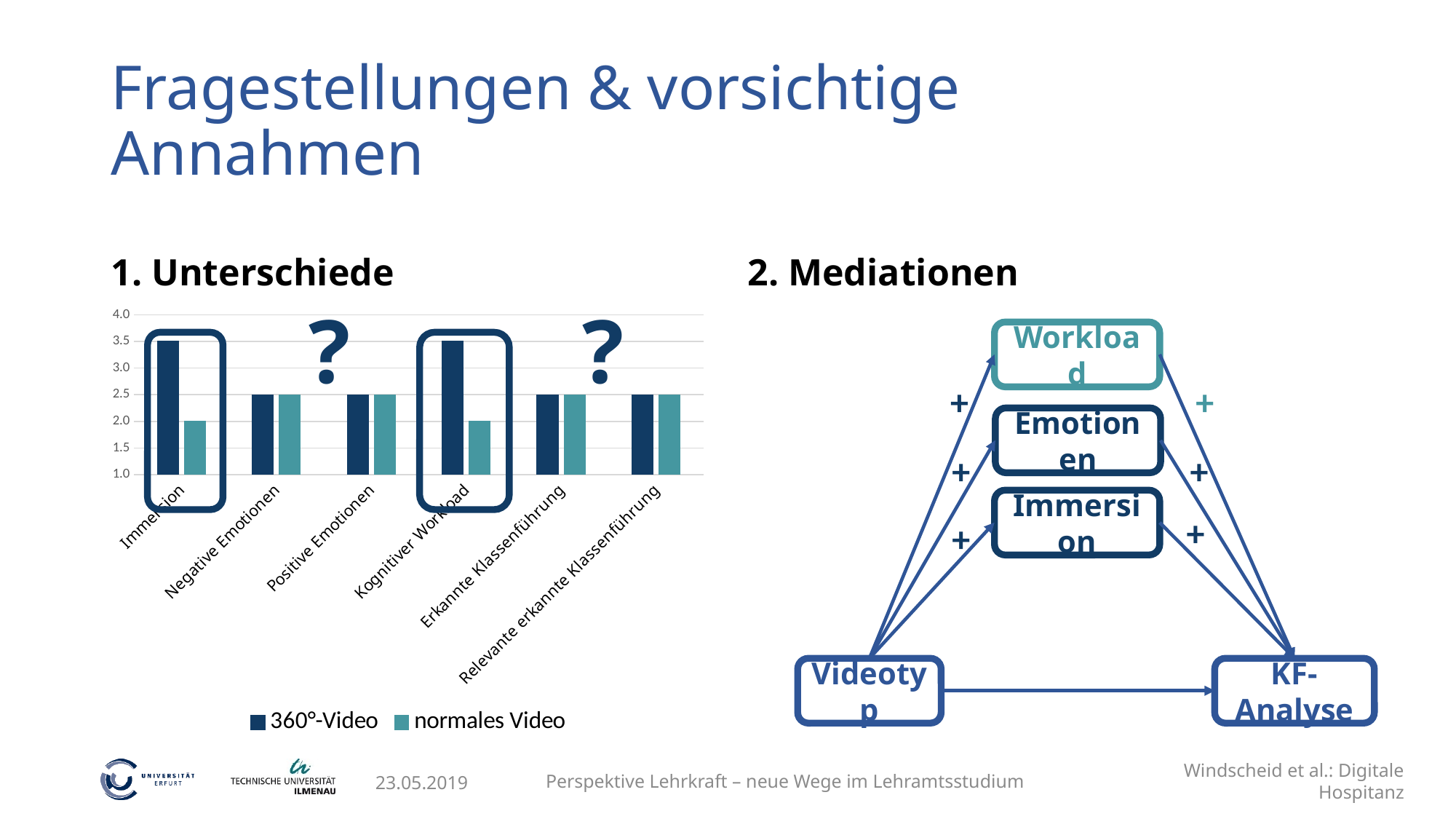
What is the difference between the 360°-Video and normales Video values in the Kognitiver Workload category? 1.5 What is the value for 360°-Video in the Immersion category? 3.5 What type of chart is shown under "1. Unterschiede"? bar chart What is the value for normales Video in the Immersion category? 2.0 How many series does the legend of the bar chart list? 2 How many categories are shown on the x axis of the bar chart? 6 In the Immersion category, which series has the larger value, 360°-Video or normales Video? 360°-Video What is the value for normales Video in the Negative Emotionen category? 2.5 What is the value for 360°-Video in the Kognitiver Workload category? 3.5 Is the value for 360°-Video in the Immersion category greater or less than 3.0? greater Which colour represents the 360°-Video series in the bar chart? dark blue What are the two series named in the legend of the bar chart? 360°-Video and normales Video